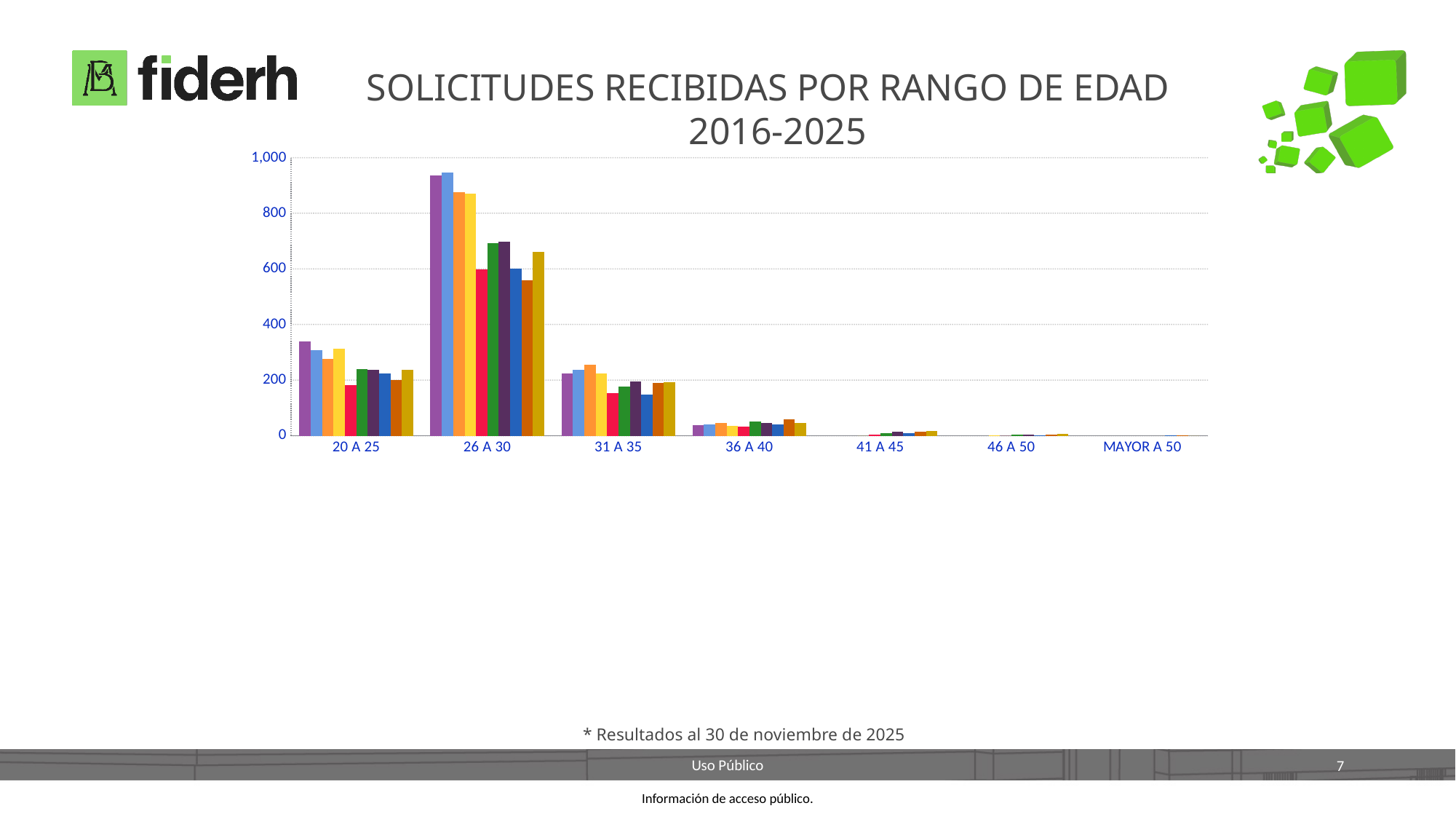
Which age range has more applications, 26 A 30 or 31 A 35? 26 A 30 Which age range has the lowest number of applications received? MAYOR A 50 Is the tallest bar in the 26 A 30 group greater or less than 800? greater How many age-range categories are shown on the x axis? 7 Do the values rise or fall along the x axis from 26 A 30 to MAYOR A 50? fall Which age range has the highest number of applications received? 26 A 30 Are all the bars in the 36 A 40 group greater or less than 200? less What kind of chart is shown on the slide? Bar chart What is the title of the chart? SOLICITUDES RECIBIDAS POR RANGO DE EDAD 2016-2025 Is the tallest bar in the 20 A 25 group greater or less than 400? less Which age range has more applications, 36 A 40 or 41 A 45? 36 A 40